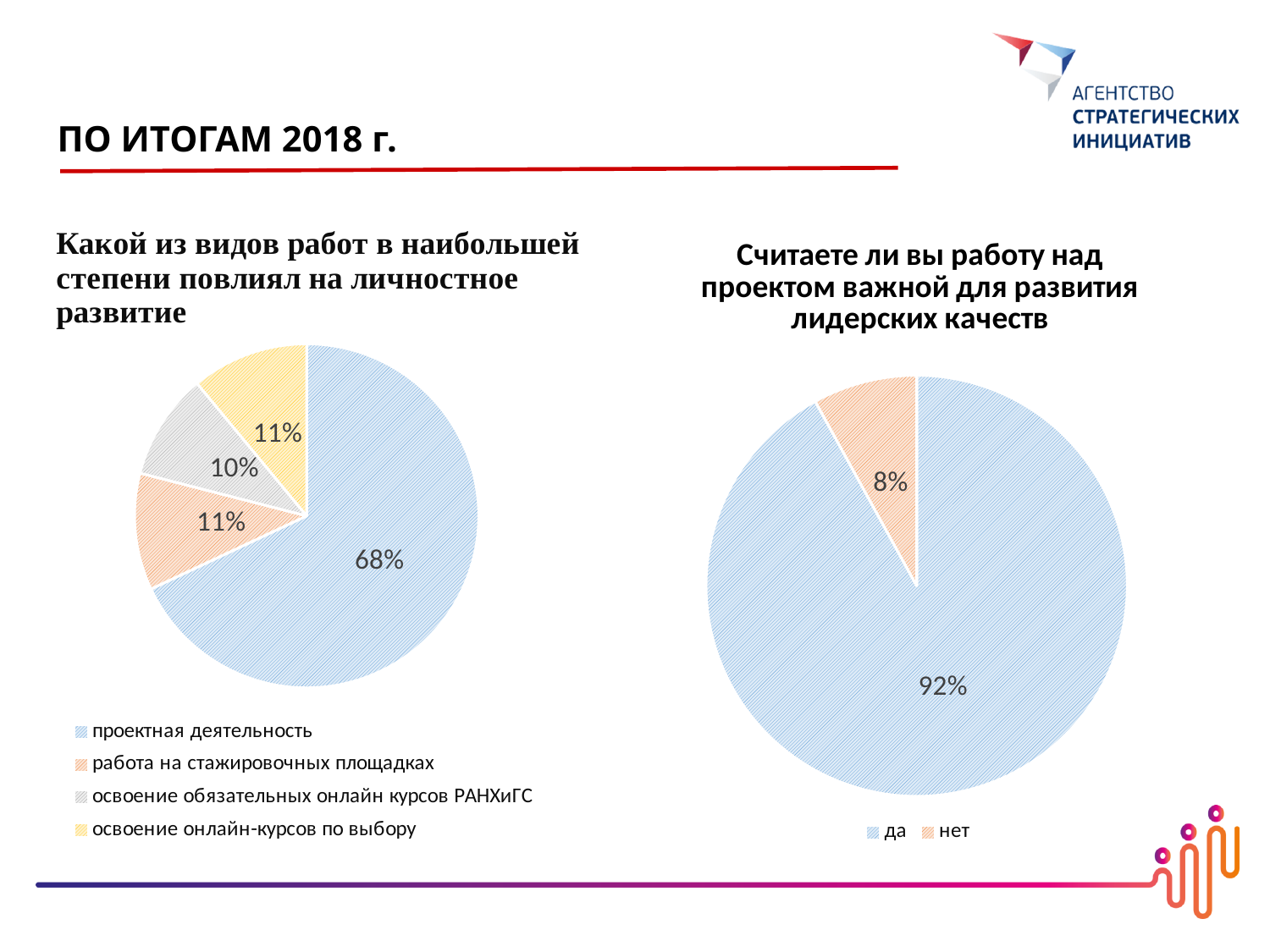
In the left chart, what is the difference between the share for проектная деятельность and the share for освоение онлайн-курсов по выбору? 57% In the left chart (Какой из видов работ в наибольшей степени повлиял на личностное развитие), what share is shown for проектная деятельность? 68% In the left chart, what share is shown for освоение обязательных онлайн курсов РАНХиГС? 10% In the right chart, what share answered нет? 8% What kind of chart is the left chart? pie chart In the right chart, what is the difference between the share for да and the share for нет? 84% How many categories does the left chart's legend list? 4 In the left chart, which category has the largest slice? проектная деятельность In the right chart (Считаете ли вы работу над проектом важной для развития лидерских качеств), what share answered да? 92% In the left chart, which category has the smallest slice? освоение обязательных онлайн курсов РАНХиГС In the left chart, what share is shown for работа на стажировочных площадках? 11% In the right chart, which is larger, the share for да or the share for нет? да